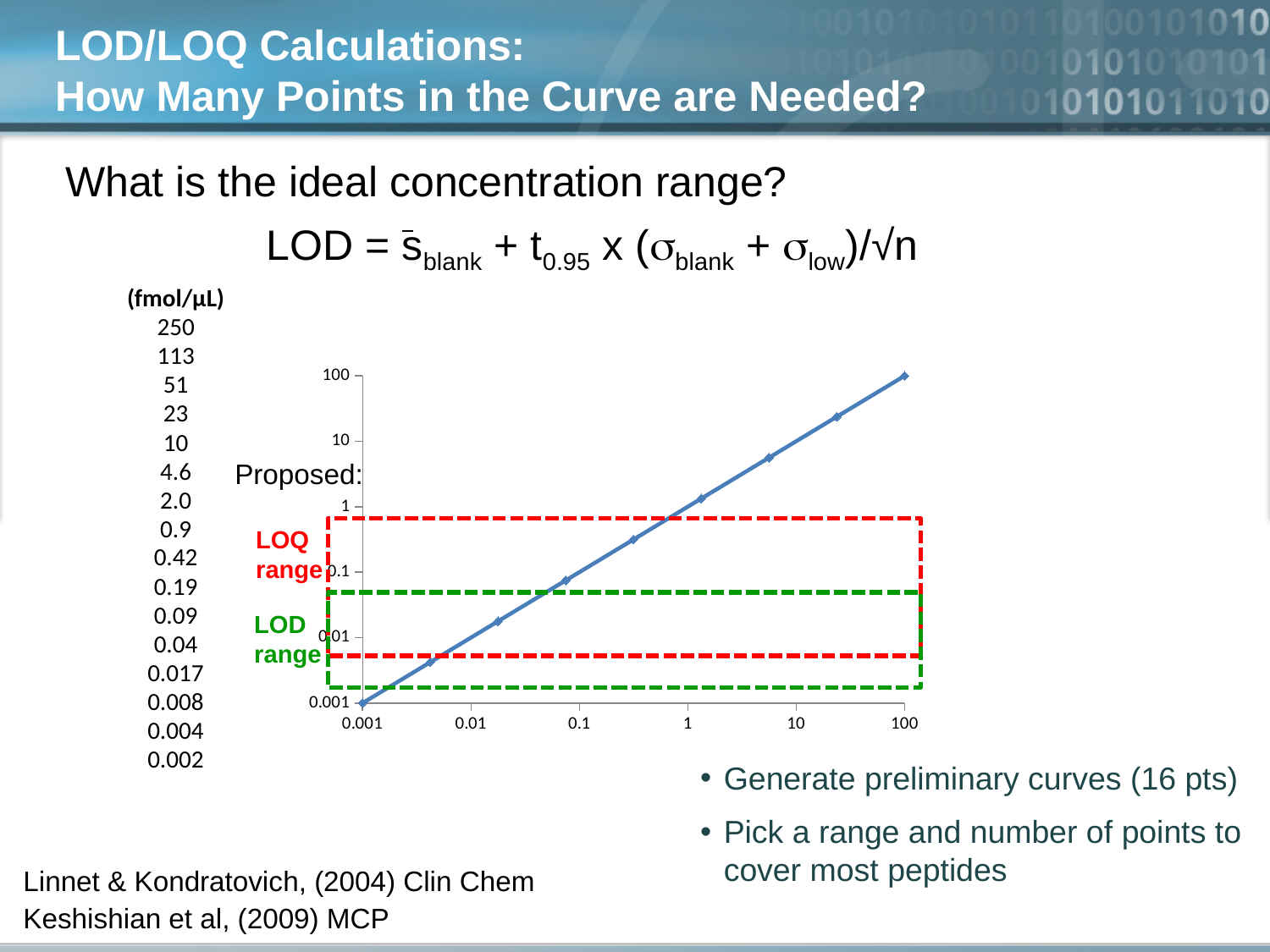
How many tick labels are shown on the x axis of the chart? 6 What is the y value of the plotted point at x = 100? 100 What kind of chart is shown on the slide? line chart At which x-axis value does the plotted line reach its lowest point? 0.001 What is the highest tick label on the y axis of the chart? 100 Is the plotted value at x = 0.01 greater or less than 0.1? less What colour is the dashed box labelled 'LOQ range'? red At which x-axis value does the plotted line reach its highest point? 100 Do the plotted values rise or fall as the x-axis value increases? rise What is the y value of the plotted point at x = 0.001? 0.001 Is the plotted value at x = 10 greater or less than 1? greater